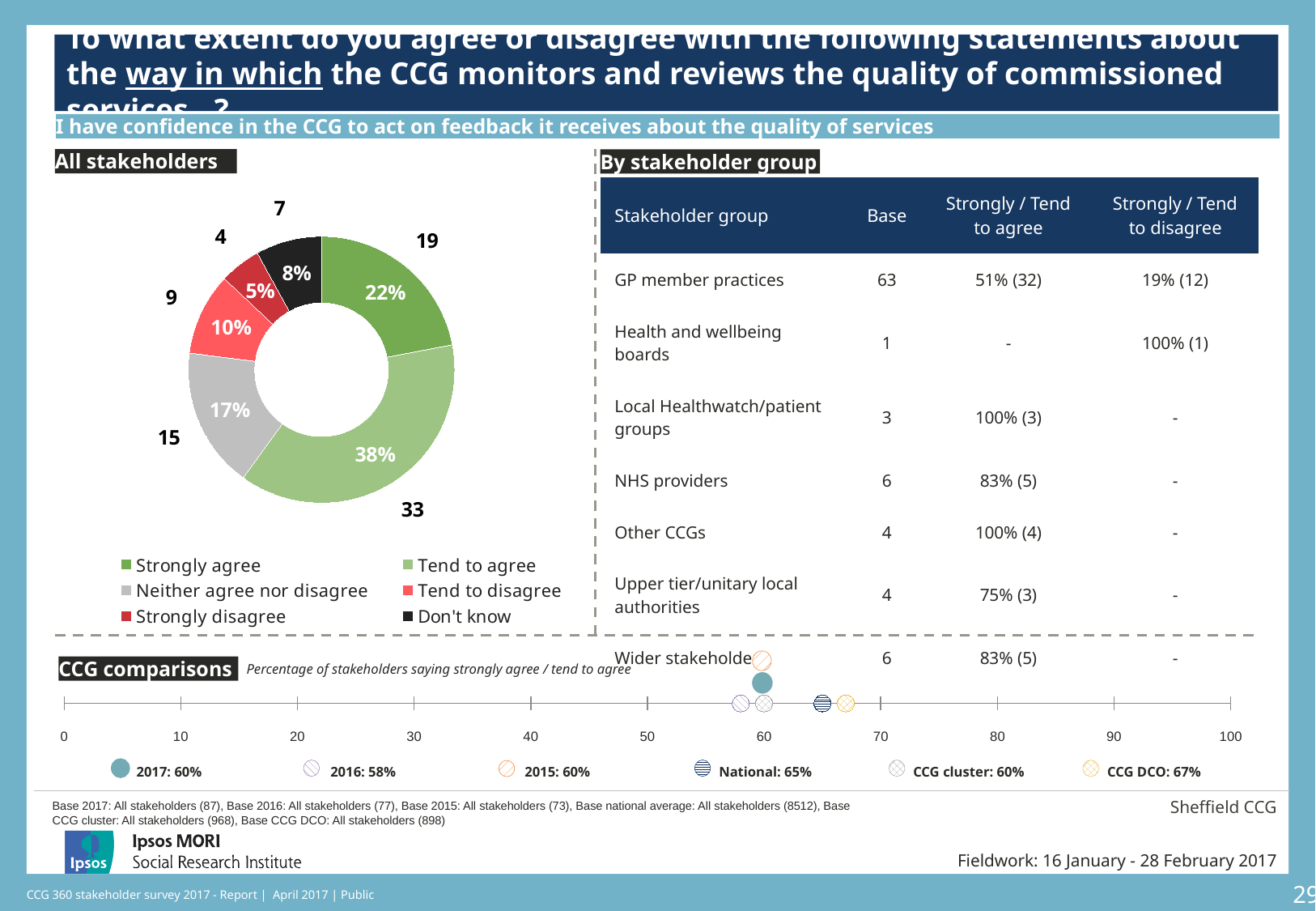
How many response categories does the legend of the 'All stakeholders' donut chart list? 6 In the 'CCG comparisons' chart, what is the difference in percentage points between the National value and the 2017 value? 5 In the 'All stakeholders' donut chart, what percentage of stakeholders said 'Tend to agree'? 38% In the 'All stakeholders' donut chart, which response category has the largest share? Tend to agree In the 'All stakeholders' donut chart, what percentage answered 'Don't know'? 8% In the 'All stakeholders' donut chart, which is larger: 'Neither agree nor disagree' or 'Tend to disagree'? Neither agree nor disagree In the 'CCG comparisons' chart, what percentage of stakeholders said strongly agree / tend to agree in 2017? 60% In the 'All stakeholders' donut chart, what is the difference in percentage points between 'Tend to agree' and 'Strongly agree'? 16 What type of chart is used for the 'All stakeholders' section? Donut chart In the 'All stakeholders' donut chart, what percentage of stakeholders said 'Strongly agree'? 22% In the 'All stakeholders' donut chart, which response category has the smallest share? Strongly disagree In the 'CCG comparisons' chart, what is the CCG DCO value? 67%